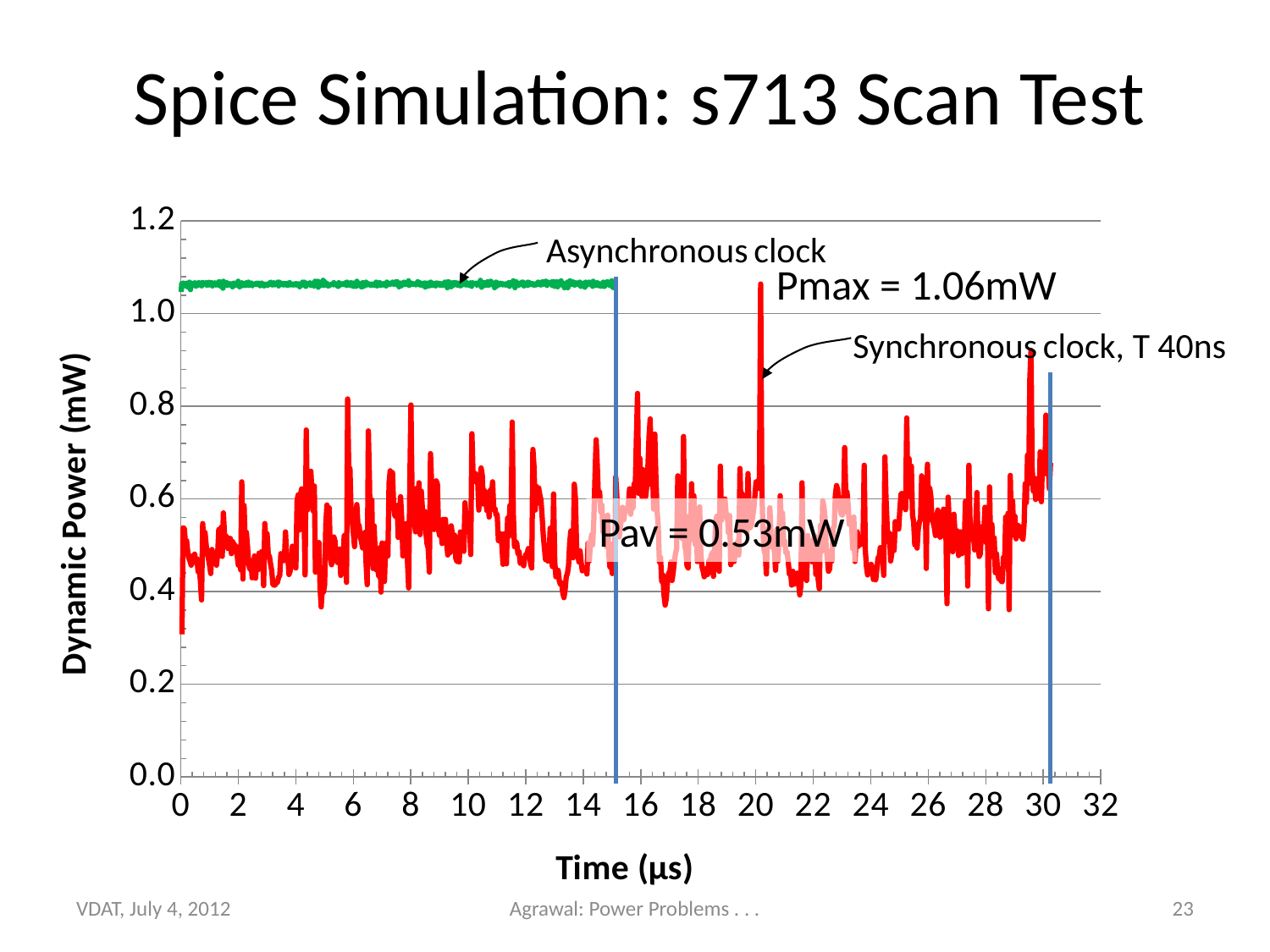
What is the clock period given for the synchronous clock in the chart annotation? 40ns Is the dynamic power of the asynchronous clock trace greater or less than 1.0 mW? greater Does the asynchronous clock trace rise, fall, or stay flat along the time axis? stays flat What kind of chart is shown on the slide? line chart What is the label of the vertical axis? Dynamic Power (mW) What is the maximum value shown on the time axis? 32 What is the title of the slide's chart? Spice Simulation: s713 Scan Test Is the dynamic power of the synchronous clock trace at 10 µs greater or less than 0.8 mW? less Which of the two plotted clocks has the higher dynamic power over the 0 to 14 µs range, the asynchronous clock or the synchronous clock? Asynchronous clock What is the difference between the annotated Pmax and Pav values? 0.53mW What is the Pav value annotated on the chart? 0.53mW What is the Pmax value annotated on the chart? 1.06mW